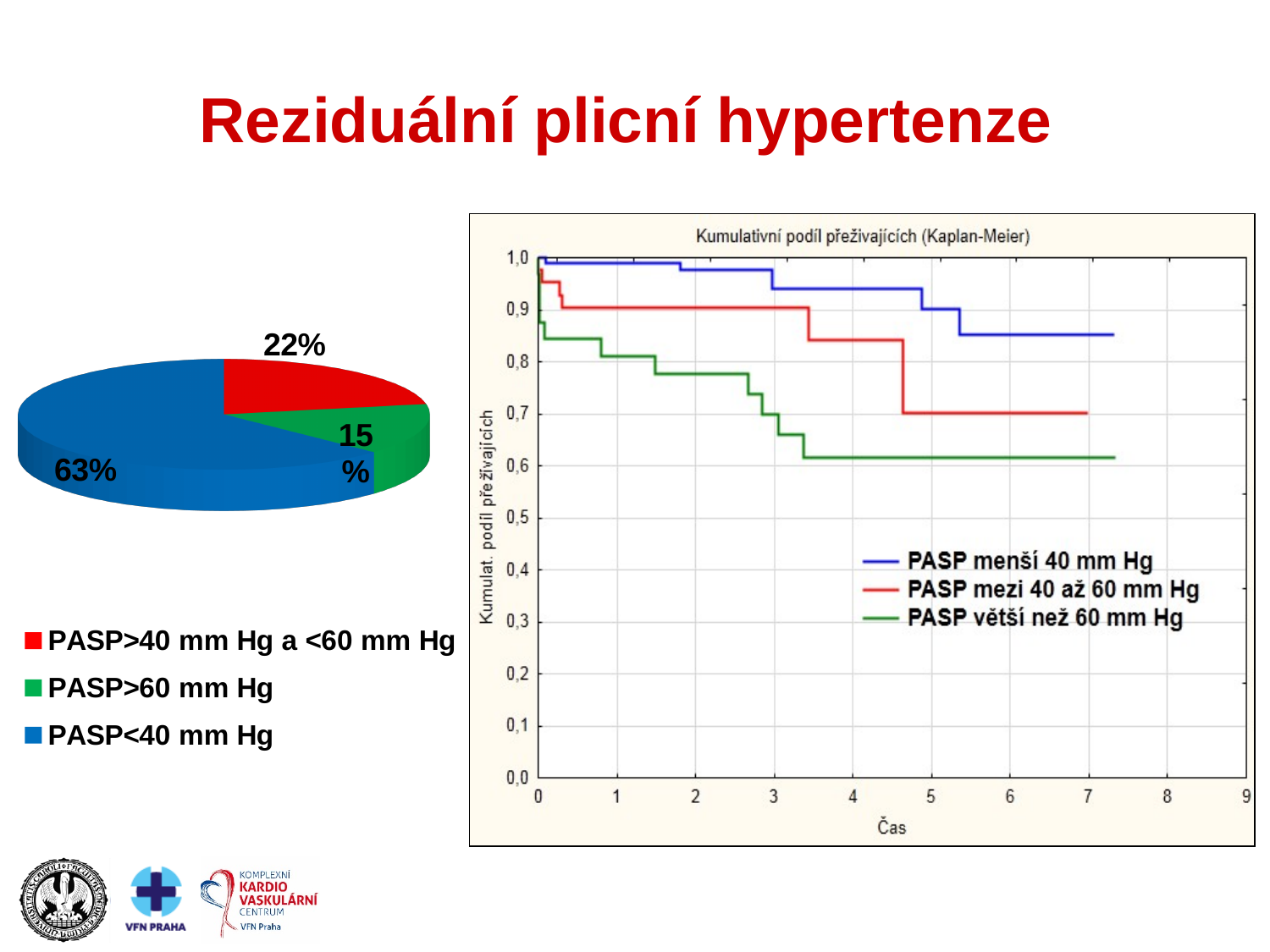
In the pie chart on the left, what share is shown for PASP>60 mm Hg? 15% In the pie chart on the left, what share is shown for PASP>40 mm Hg a <60 mm Hg? 22% What type of chart is the chart on the right titled 'Kumulativní podíl přeživajících (Kaplan-Meier)'? line chart In the Kaplan-Meier chart on the right, how many series does the legend list? 3 In the Kaplan-Meier chart on the right, is the value for PASP větší než 60 mm Hg at time 7 greater or less than 0,7? less In the pie chart on the left, how many categories are shown? 3 In the Kaplan-Meier chart on the right, do the values rise or fall along the x axis? fall In the Kaplan-Meier chart on the right, which series has the highest value at time 7? PASP menší 40 mm Hg In the pie chart on the left, what share is shown for PASP<40 mm Hg? 63% In the pie chart on the left, which category has the smallest share? PASP>60 mm Hg In the pie chart on the left, how many percentage points larger is the PASP<40 mm Hg share than the PASP>40 mm Hg a <60 mm Hg share? 41 In the pie chart on the left, which category has the largest share? PASP<40 mm Hg